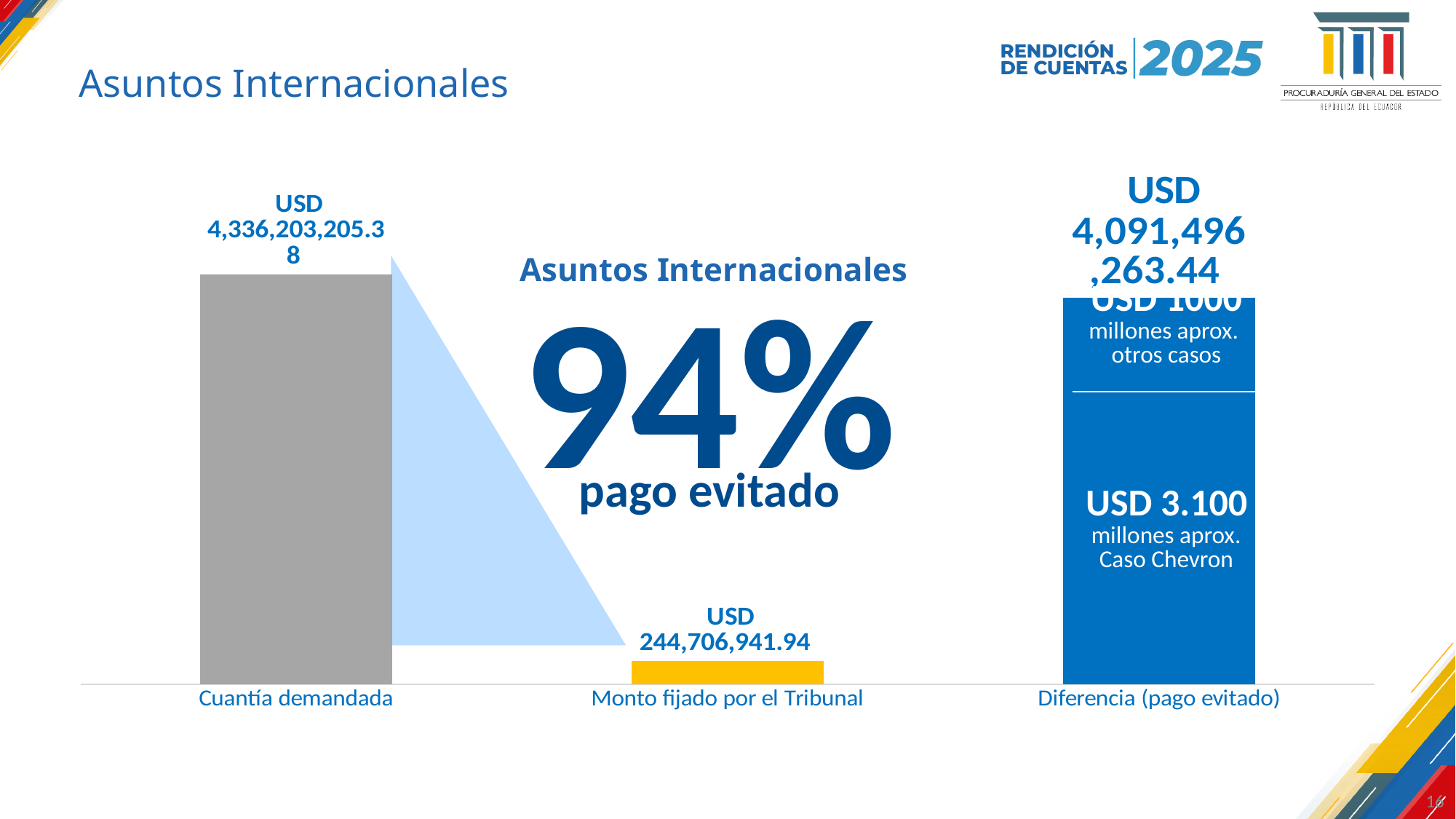
What is the value for Diferencia (pago evitado)? USD 4,091,496,263.44 Which is larger, Monto fijado por el Tribunal or Diferencia (pago evitado)? Diferencia (pago evitado) What is the title of the chart? Asuntos Internacionales What is the difference between Cuantía demandada and Monto fijado por el Tribunal? USD 4,091,496,263.44 What is the value for Cuantía demandada? USD 4,336,203,205.38 Which category has the highest value? Cuantía demandada How many categories are shown in the chart? 3 What percentage of payment avoided (pago evitado) is highlighted on the chart? 94% What kind of chart is shown on the slide? Bar chart Which is larger, Cuantía demandada or Diferencia (pago evitado)? Cuantía demandada Which category has the lowest value? Monto fijado por el Tribunal What is the value for Monto fijado por el Tribunal? USD 244,706,941.94